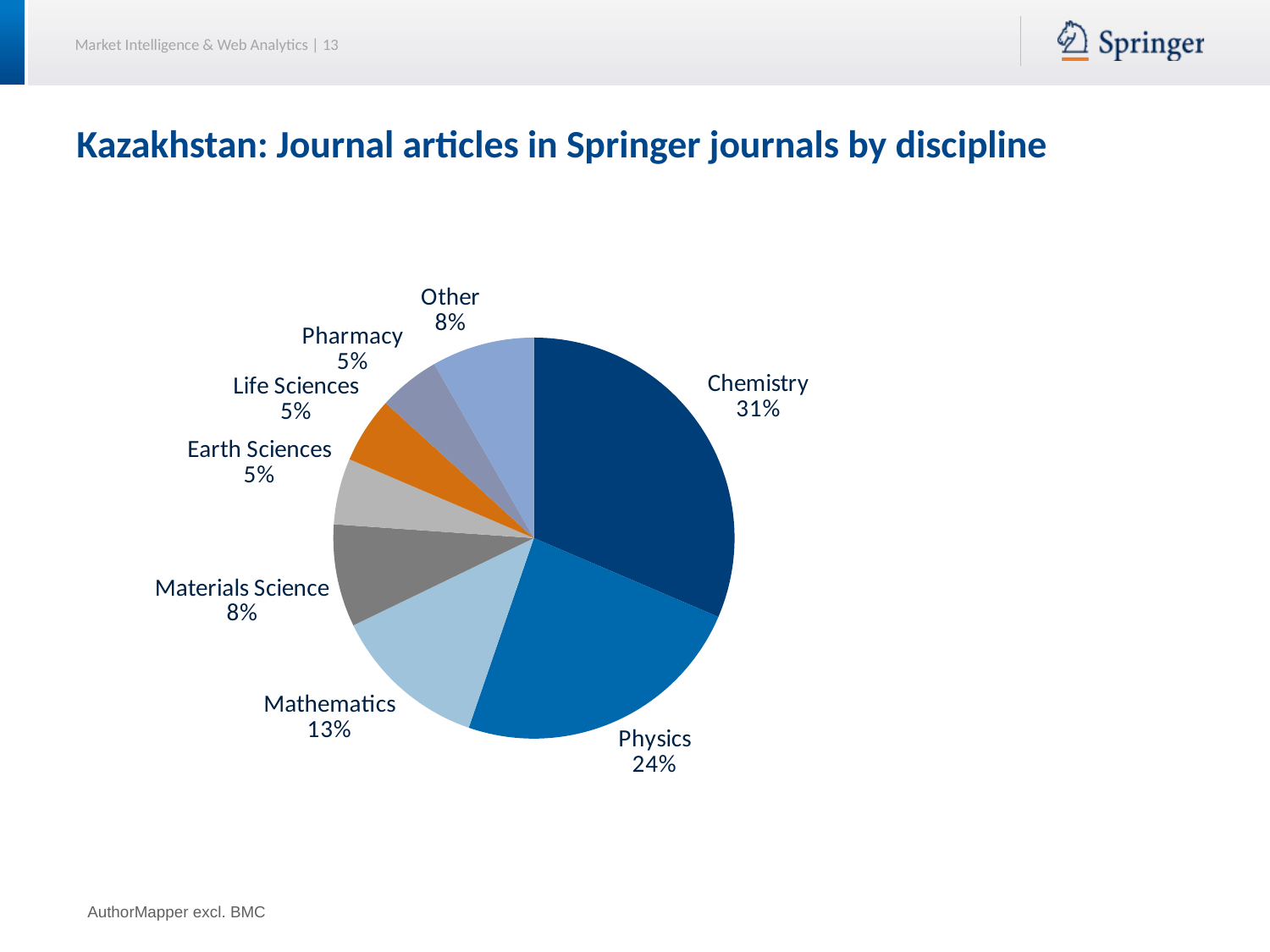
How many slices does the pie chart have? 8 What kind of chart is shown on the slide? pie chart Which has a larger share, Mathematics or Materials Science? Mathematics What is the difference in share between Chemistry and Physics? 7% What share of journal articles is in Chemistry? 31% What share of journal articles is in Materials Science? 8% What share of journal articles is in Earth Sciences? 5% Which discipline has the largest share of journal articles? Chemistry What share of journal articles is in Physics? 24% What is the combined share of Chemistry and Physics? 55% What is the title of the chart on the slide? Kazakhstan: Journal articles in Springer journals by discipline What share of journal articles is in Mathematics? 13%